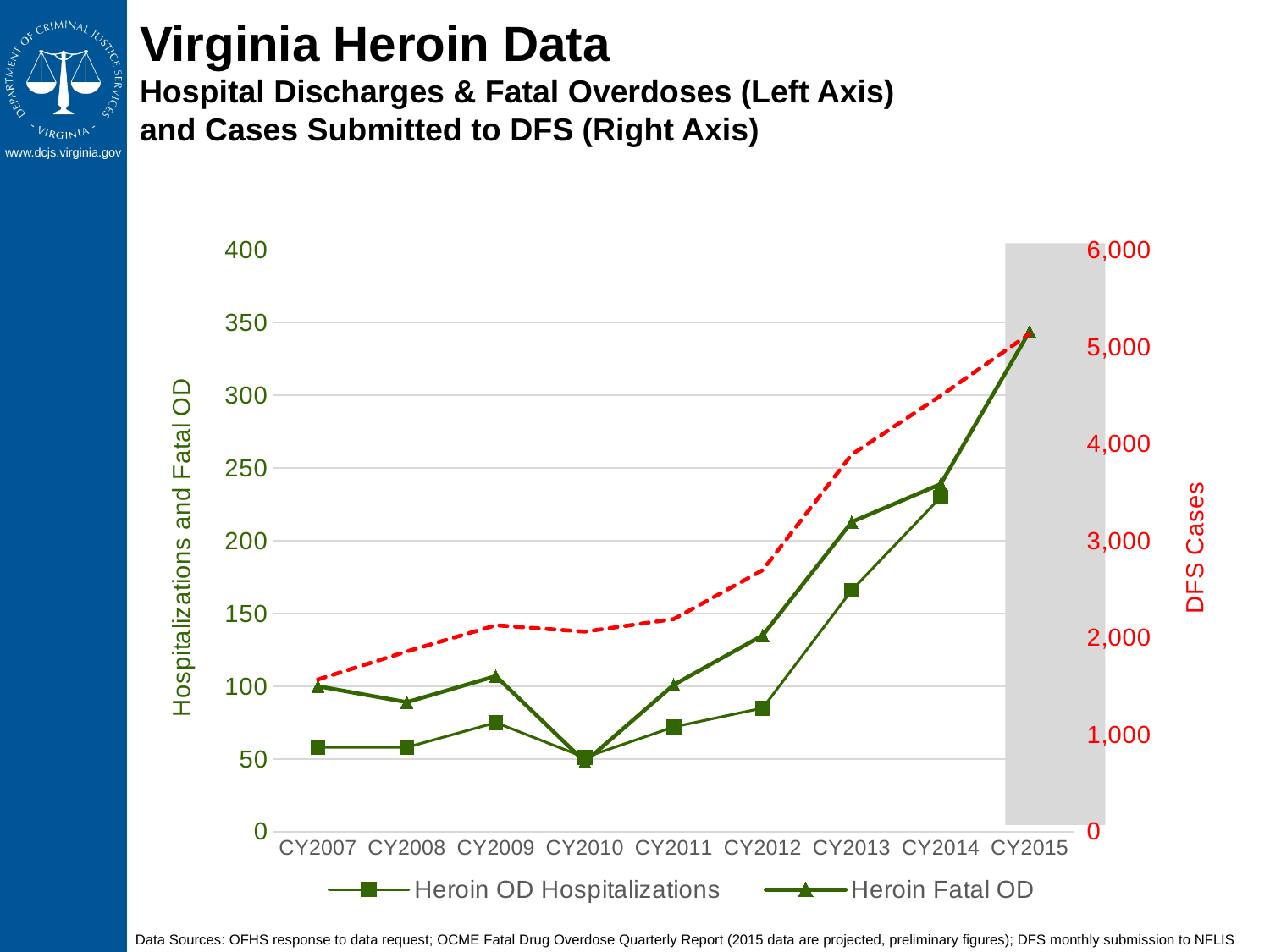
Is the value for Heroin Fatal OD in CY2013 greater or less than 200? greater Is the value for Heroin Fatal OD in CY2012 greater or less than 150? less How many calendar years are shown on the x axis of the chart? 9 What kind of chart is shown on the slide? line chart In which year is the Heroin OD Hospitalizations series at its highest? CY2014 In which year is the Heroin Fatal OD series at its lowest? CY2010 Is the value for Heroin OD Hospitalizations in CY2013 greater or less than 200? less What is the title of the right-hand vertical axis? DFS Cases How many series does the chart's legend list? 2 In CY2011, which is larger: Heroin Fatal OD or Heroin OD Hospitalizations? Heroin Fatal OD